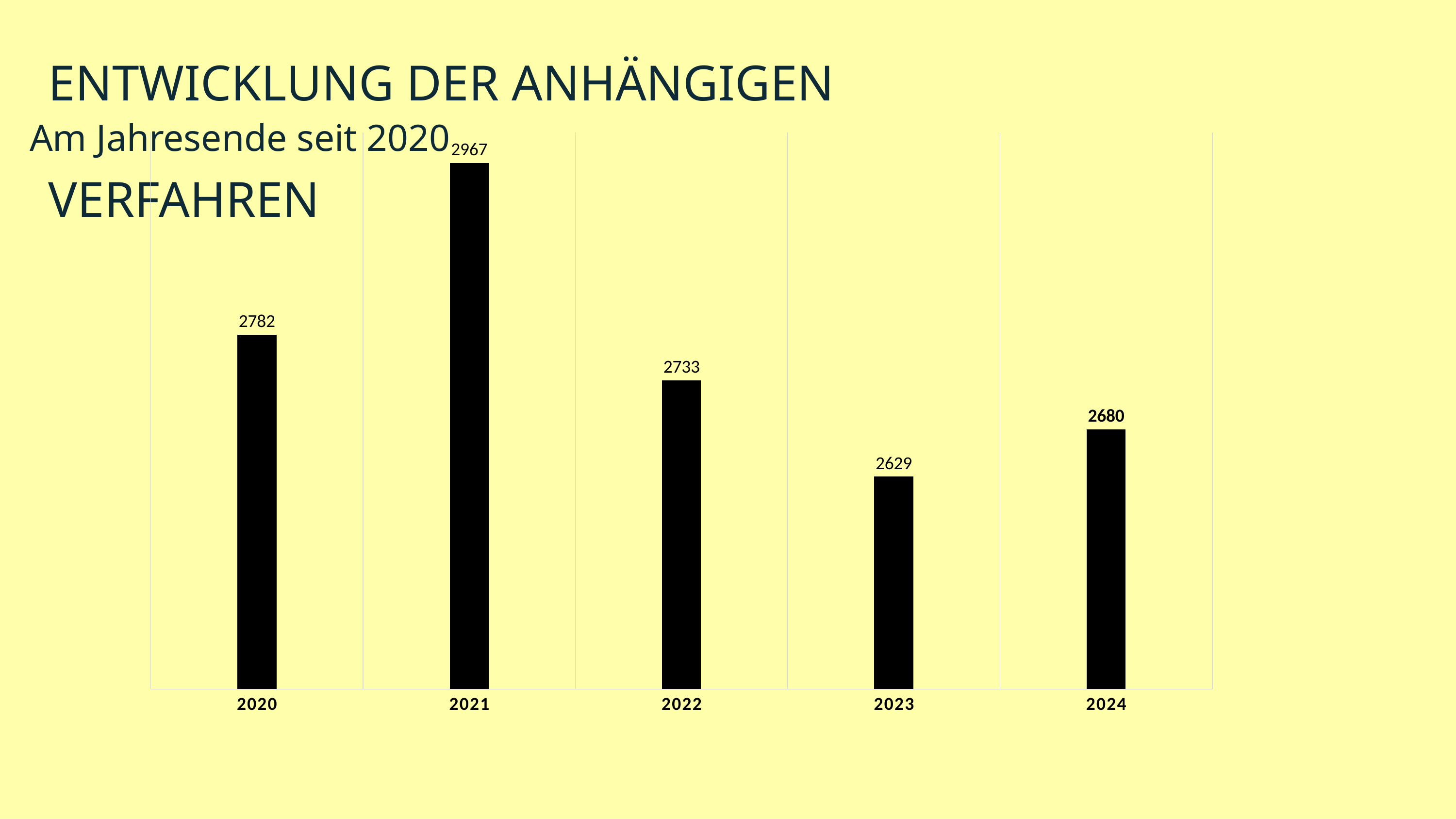
What is the value for 2023? 2629 Which is larger, the value for 2020 or the value for 2022? 2020 How many years are shown on the chart? 5 What is the difference between the values for 2021 and 2020? 185 Do the values rise or fall from 2021 to 2023? fall What is the value for 2021? 2967 What kind of chart is shown on the slide? bar chart What is the difference between the values for 2024 and 2023? 51 What colour are the bars in the chart? black What is the value for 2024? 2680 Which year has the lowest value? 2023 Which year has the highest value? 2021